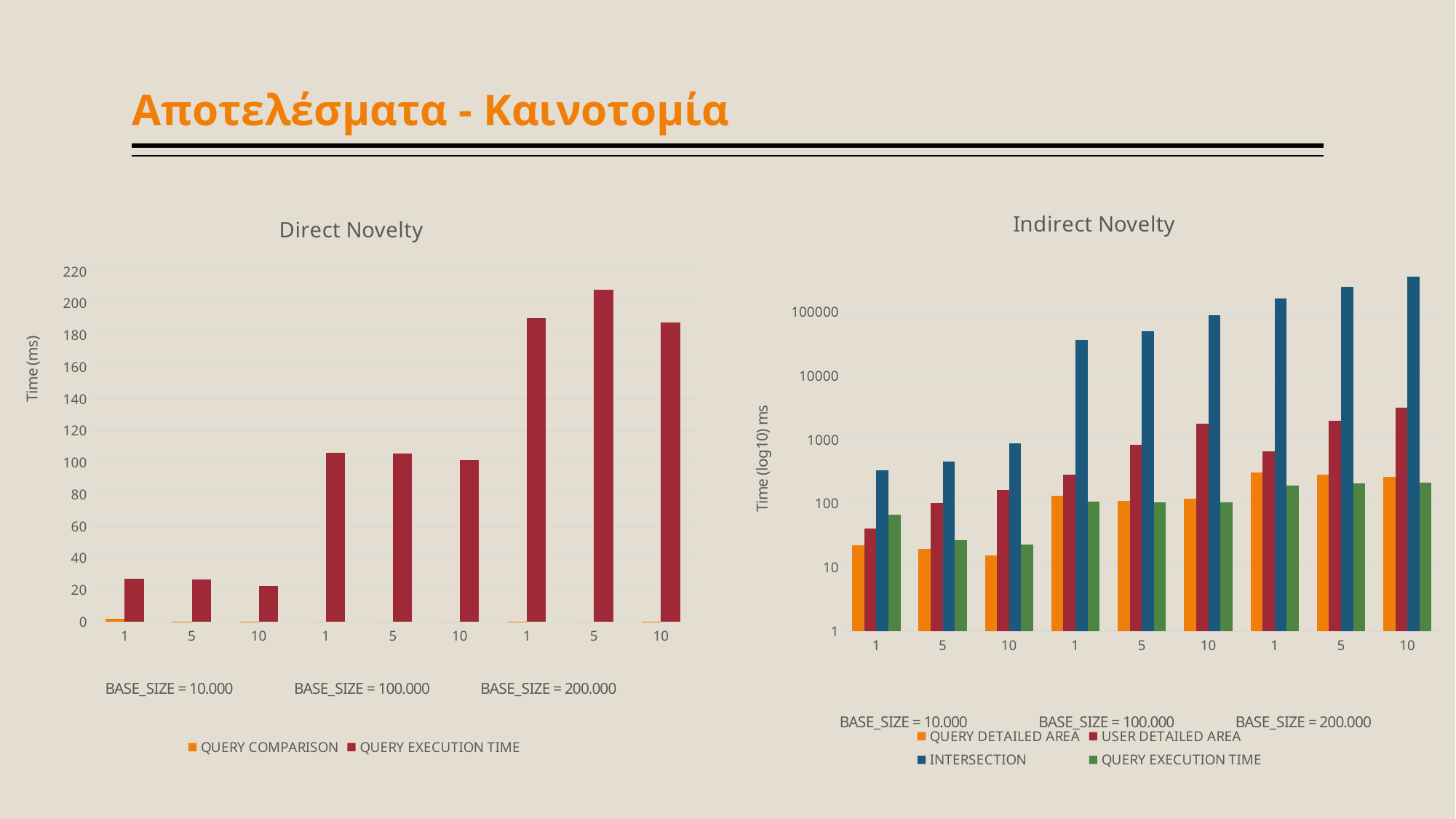
In the Direct Novelty chart, is the QUERY EXECUTION TIME for 5 under BASE_SIZE = 200.000 greater or less than 200? greater In the Direct Novelty chart, is the QUERY EXECUTION TIME for 1 under BASE_SIZE = 10.000 greater or less than 40? less What kind of chart is the Direct Novelty chart? bar chart How many series does the legend of the Indirect Novelty chart list? 4 In the Direct Novelty chart, which category has the highest QUERY EXECUTION TIME? 5 (BASE_SIZE = 200.000) In the Indirect Novelty chart, is the INTERSECTION value for 10 under BASE_SIZE = 200.000 greater or less than 100000? greater In the Direct Novelty chart, which is larger: QUERY EXECUTION TIME for 1 under BASE_SIZE = 100.000 or for 1 under BASE_SIZE = 200.000? 1 under BASE_SIZE = 200.000 In the Indirect Novelty chart, which series has the tallest bars overall? INTERSECTION In the Direct Novelty chart, how many bar groups (x-axis categories) are plotted? 9 How many series does the legend of the Direct Novelty chart list? 2 What is the y-axis label of the Indirect Novelty chart? Time (log10) ms